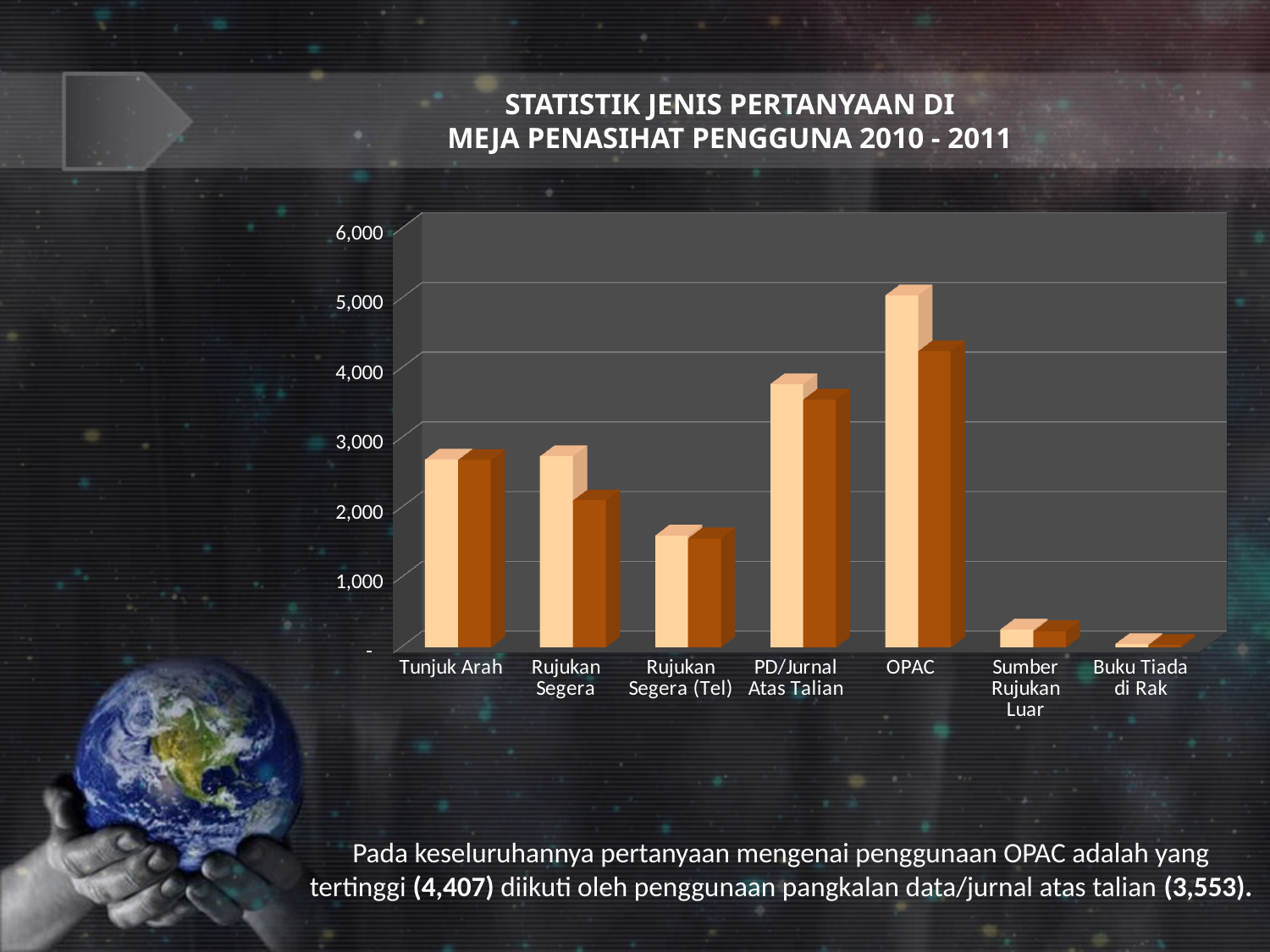
Which category has higher bars, OPAC or Tunjuk Arah? OPAC Are the values for PD/Jurnal Atas Talian greater or less than 3,000? greater How many categories are shown on the x axis of the chart? 7 Which category has the highest bars in the chart? OPAC Are the values for Rujukan Segera (Tel) greater or less than 2,000? less Are the values for Tunjuk Arah greater or less than 3,000? less What kind of chart is shown on the slide? bar chart What is the title of the chart? STATISTIK JENIS PERTANYAAN DI MEJA PENASIHAT PENGGUNA 2010 - 2011 Which category has higher bars, PD/Jurnal Atas Talian or Rujukan Segera (Tel)? PD/Jurnal Atas Talian Which category has the lowest bars in the chart? Buku Tiada di Rak